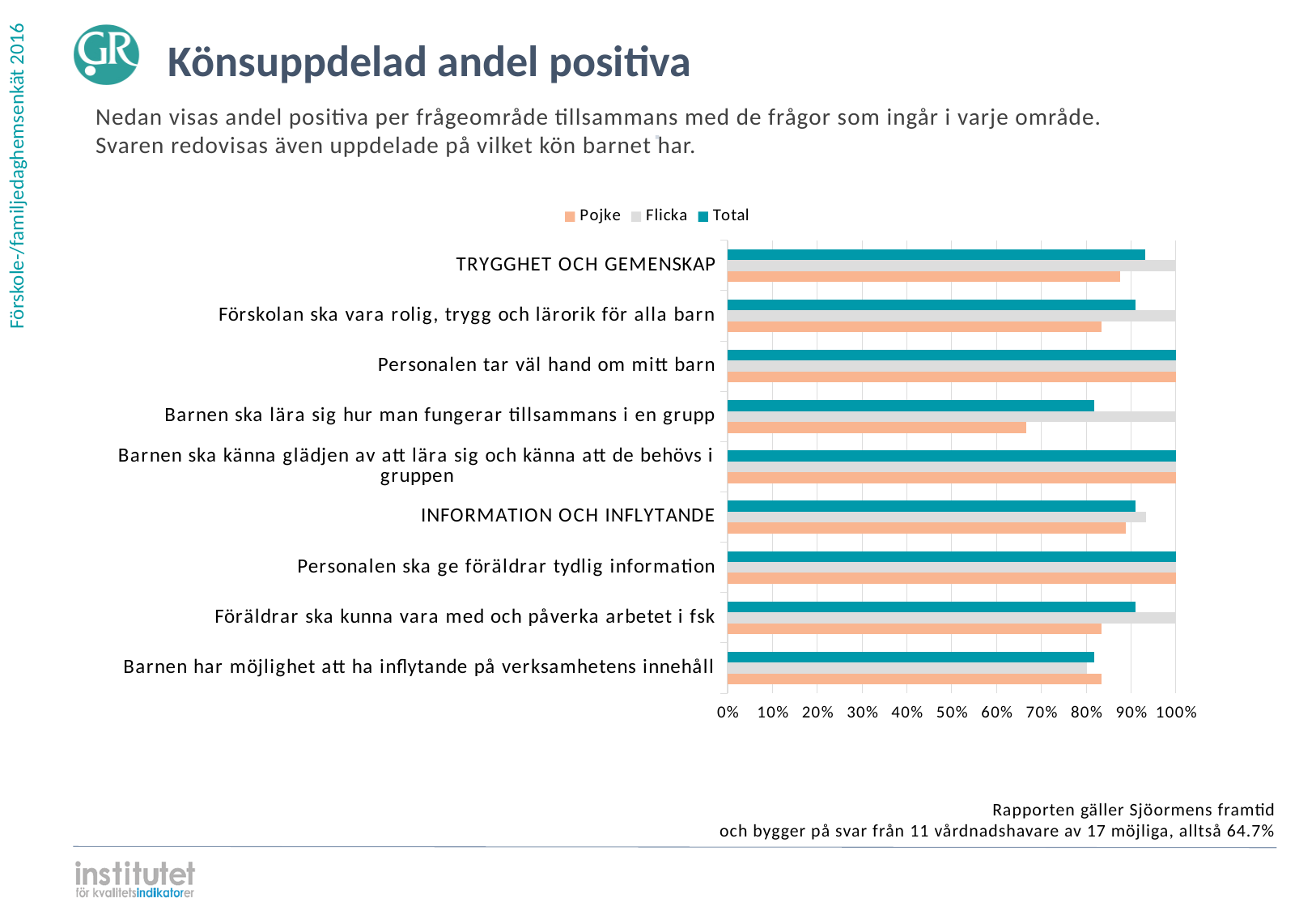
Is the Pojke value for 'TRYGGHET OCH GEMENSKAP' greater or less than 90%? less Is the Pojke value for 'Barnen ska lära sig hur man fungerar tillsammans i en grupp' greater or less than 70%? less What is the Flicka value for 'Personalen tar väl hand om mitt barn'? 100% Is the Total value for 'Barnen ska lära sig hur man fungerar tillsammans i en grupp' greater or less than 80%? greater For 'Föräldrar ska kunna vara med och påverka arbetet i fsk', which is larger, the Pojke value or the Flicka value? Flicka How many categories are plotted on the chart? 9 What are the three series named in the legend? Pojke, Flicka, Total What is the Flicka value for 'TRYGGHET OCH GEMENSKAP'? 100% What is the Total value for 'Personalen ska ge föräldrar tydlig information'? 100% What kind of chart is shown on the slide? bar chart Which category has the lowest Pojke value? Barnen ska lära sig hur man fungerar tillsammans i en grupp How many series does the legend list? 3